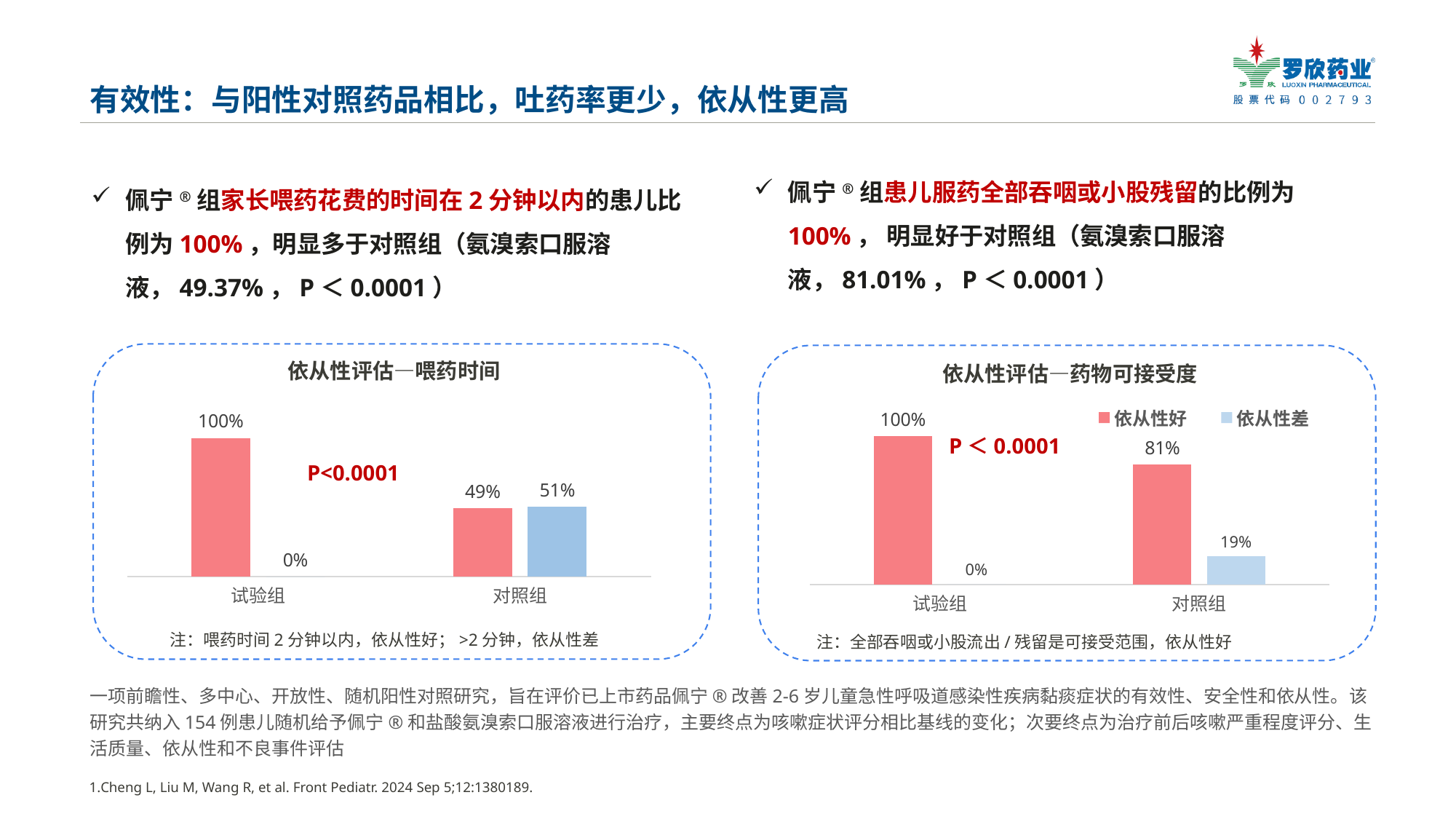
In the chart titled 依从性评估—药物可接受度, what is the value of the 依从性好 bar for 对照组? 81% In the chart titled 依从性评估—药物可接受度, what is the value of the 依从性差 bar for 对照组? 19% In the chart titled 依从性评估—喂药时间, what is the value of the red bar (依从性好) for 试验组? 100% In the chart titled 依从性评估—药物可接受度, what is the value of the 依从性差 bar for 试验组? 0% In the chart titled 依从性评估—喂药时间, what is the difference between the red bar for 试验组 and the red bar for 对照组? 51% How many categories are shown on the x axis of the chart titled 依从性评估—药物可接受度? 2 How many series does the legend of the chart titled 依从性评估—药物可接受度 list? 2 What kind of chart is the chart titled 依从性评估—喂药时间? Bar chart In the chart titled 依从性评估—药物可接受度, which group has the higher 依从性好 value, 试验组 or 对照组? 试验组 In the chart titled 依从性评估—喂药时间, what is the value of the blue bar for 对照组? 51% In the chart titled 依从性评估—药物可接受度, what is the difference between the 依从性好 bar for 试验组 and the 依从性好 bar for 对照组? 19% In the chart titled 依从性评估—喂药时间, what is the value of the red bar for 对照组? 49%